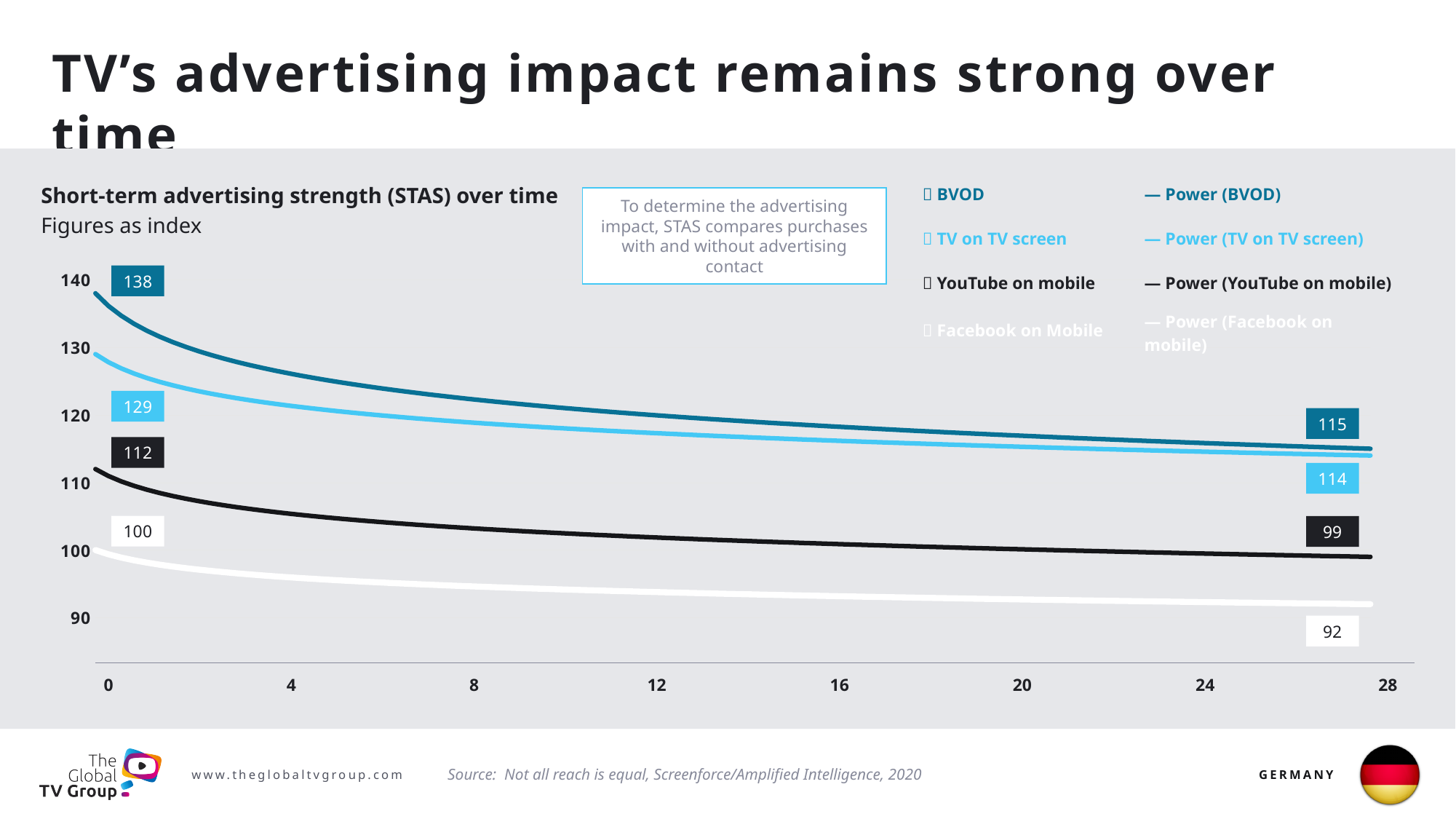
What is the starting value of the YouTube on mobile line? 112 Do the plotted lines rise or fall as the x axis increases from 0 to 28? fall What is the difference between the starting value of TV on TV screen (129) and its final value (114)? 15 At the start of the chart, which is higher: BVOD or TV on TV screen? BVOD What is the final value of the TV on TV screen line at the right end of the chart? 114 What is the final value of the Facebook on Mobile line? 92 What kind of chart is shown on the slide? line chart Which series has the highest starting value? BVOD What is the starting value (at 0) of the BVOD line? 138 How many lines are plotted on the chart? 4 By how much does the BVOD line fall from its starting value (138) to its final value (115)? 23 Which series has the lowest value at the right end of the chart? Facebook on Mobile